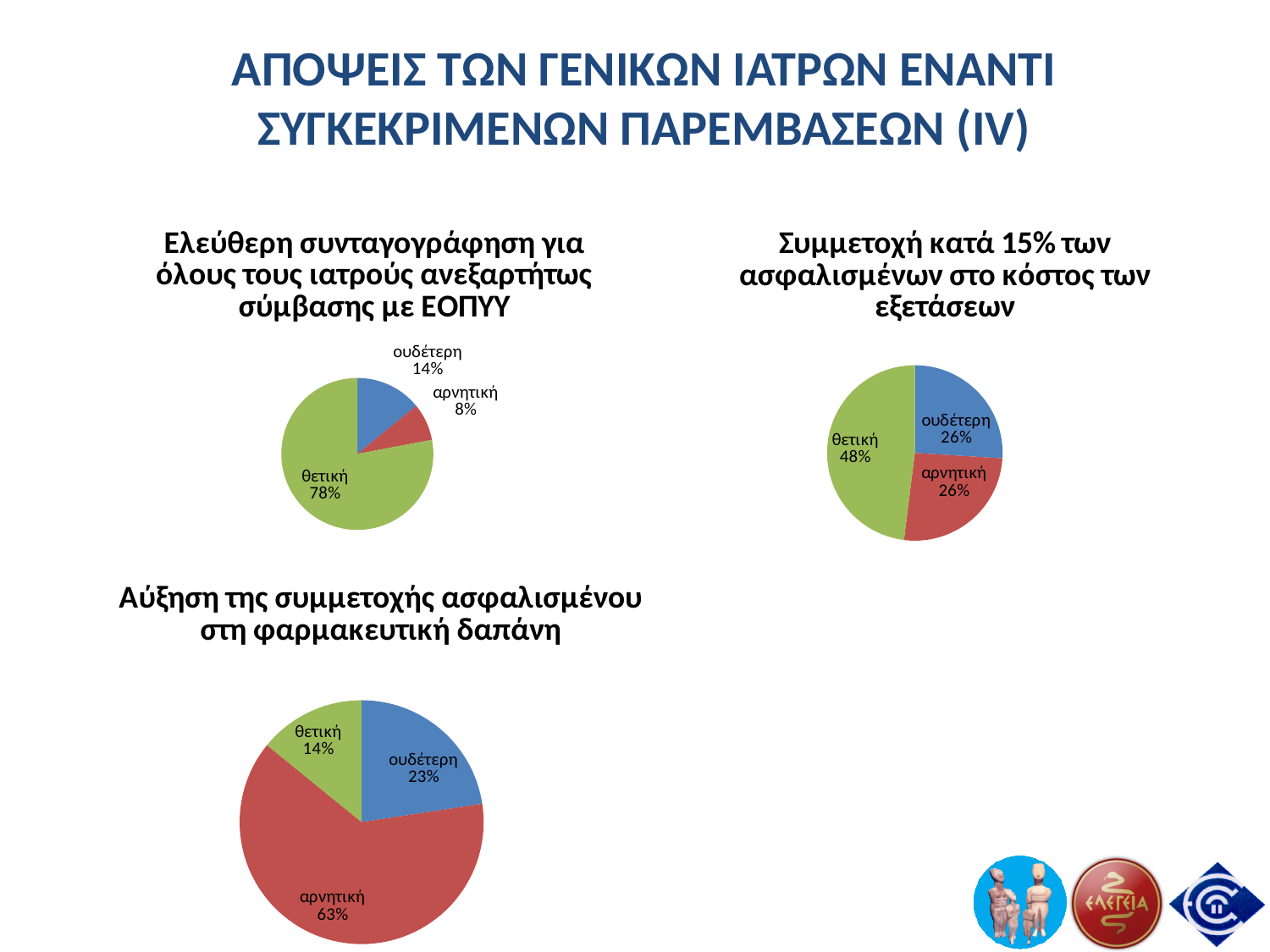
In the bottom-left pie chart (Αύξηση της συμμετοχής ασφαλισμένου), what share is ουδέτερη? 23% How many slices does the bottom-left pie chart (Αύξηση της συμμετοχής ασφαλισμένου) have? 3 In the top-right pie chart (Συμμετοχή κατά 15%), which category has the largest share? θετική In the top-left pie chart (Ελεύθερη συνταγογράφηση), what share is αρνητική? 8% In the bottom-left pie chart (Αύξηση της συμμετοχής ασφαλισμένου), which is larger, θετική or ουδέτερη? ουδέτερη In the top-right pie chart (Συμμετοχή κατά 15% των ασφαλισμένων στο κόστος των εξετάσεων), what share is θετική? 48% In the top-left pie chart (Ελεύθερη συνταγογράφηση για όλους τους ιατρούς ανεξαρτήτως σύμβασης με ΕΟΠΥΥ), what share is θετική? 78% In the top-left pie chart (Ελεύθερη συνταγογράφηση), what is the difference between the θετική and ουδέτερη shares? 64% In the top-left pie chart (Ελεύθερη συνταγογράφηση), which category has the smallest share? αρνητική What type of chart is used for the top-right chart (Συμμετοχή κατά 15%)? pie chart In the top-right pie chart (Συμμετοχή κατά 15%), what share is αρνητική? 26% In the bottom-left pie chart (Αύξηση της συμμετοχής ασφαλισμένου στη φαρμακευτική δαπάνη), what share is αρνητική? 63%